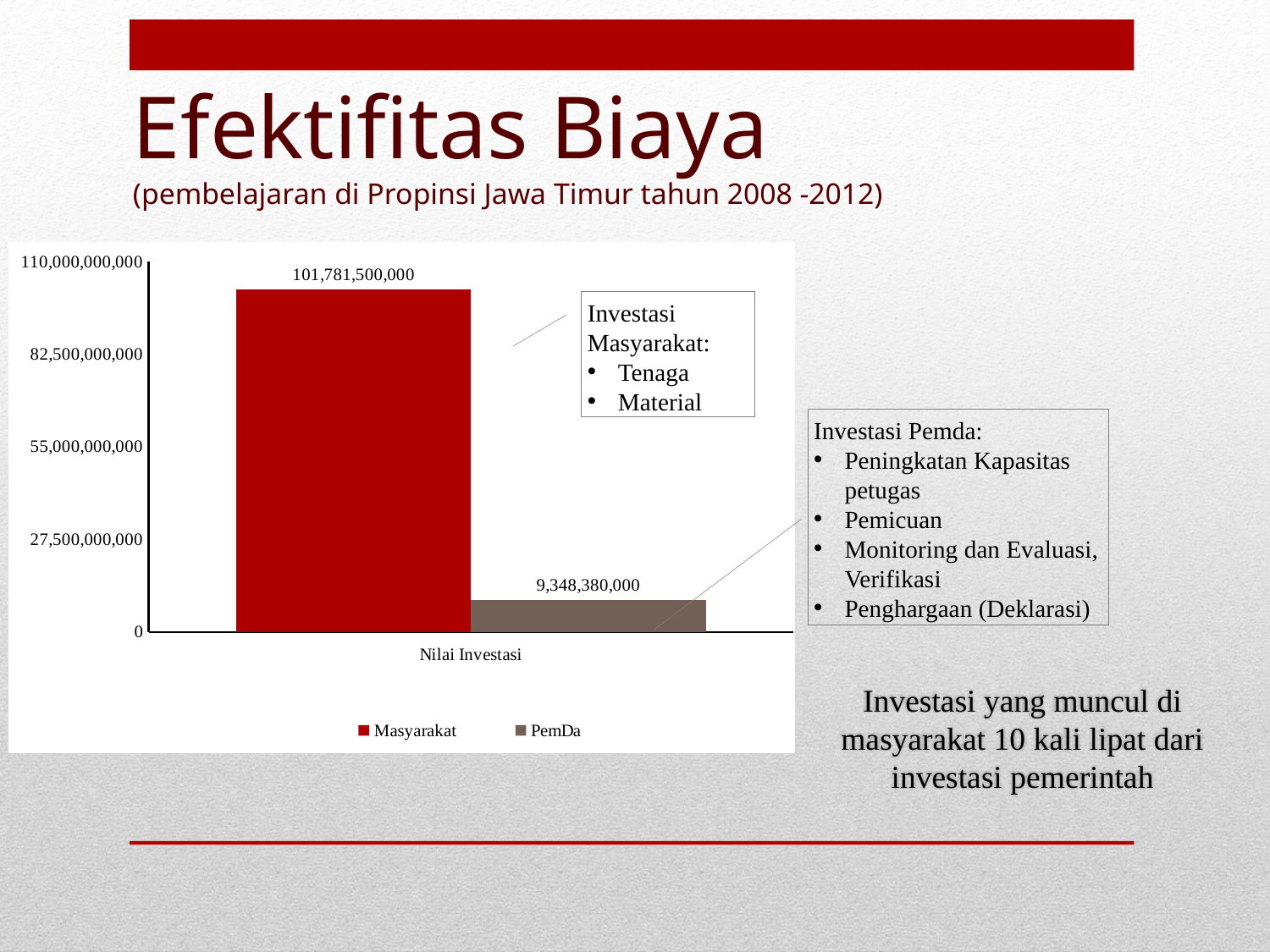
Is the value for Masyarakat greater or less than 82,500,000,000? greater Which series has the higher value, Masyarakat or PemDa? Masyarakat What is the label of the category on the x axis? Nilai Investasi What is the difference between the Masyarakat value and the PemDa value? 92,433,120,000 How many categories are shown on the x axis? 1 Which series has the lowest value in the chart? PemDa What is the value of the PemDa bar? 9,348,380,000 What colour is the Masyarakat bar? red What kind of chart is shown on the slide? bar chart Is the value for PemDa greater or less than 27,500,000,000? less What is the value of the Masyarakat bar? 101,781,500,000 How many series does the legend list? 2